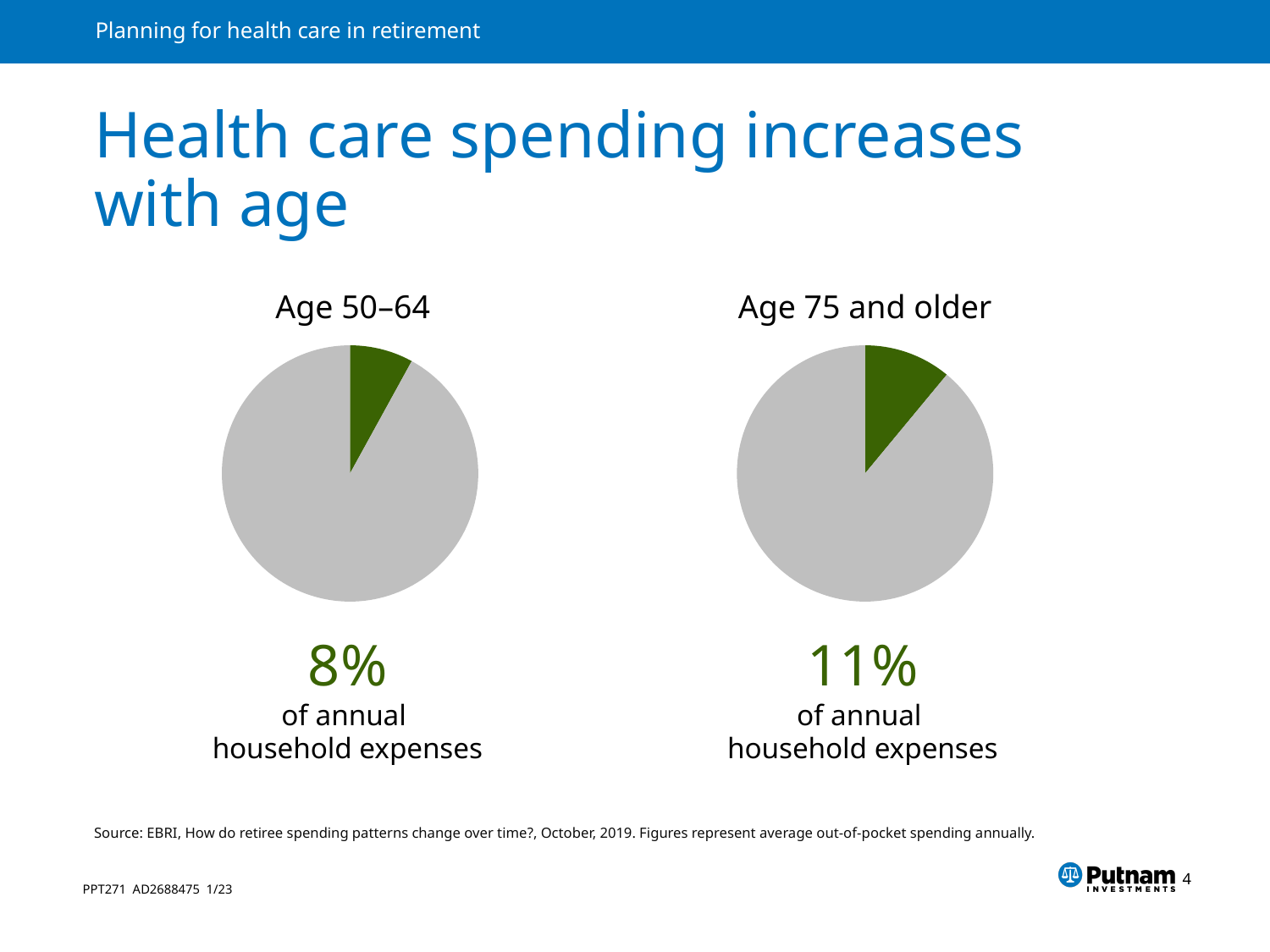
How many pie charts are shown on the slide? 2 In the 'Age 50–64' pie chart, what share of annual household expenses does the green slice represent? 8% In the 'Age 50–64' pie chart, is the green slice greater or less than 10%? less In the 'Age 75 and older' pie chart, is the green slice greater or less than 10%? greater What is the difference in percentage points between the health care share for 'Age 75 and older' and for 'Age 50–64'? 3 percentage points Which age group has the highest share of annual household expenses spent on health care? Age 75 and older Which age group has the lowest share of annual household expenses spent on health care? Age 50–64 What is the title of the pie chart on the left? Age 50–64 Which age group's pie chart shows the larger share of annual household expenses going to health care? Age 75 and older What kind of chart is used for the 'Age 50–64' group? Pie chart What colour is the slice representing health care spending in both pie charts? Green In the 'Age 75 and older' pie chart, what share of annual household expenses does the green slice represent? 11%